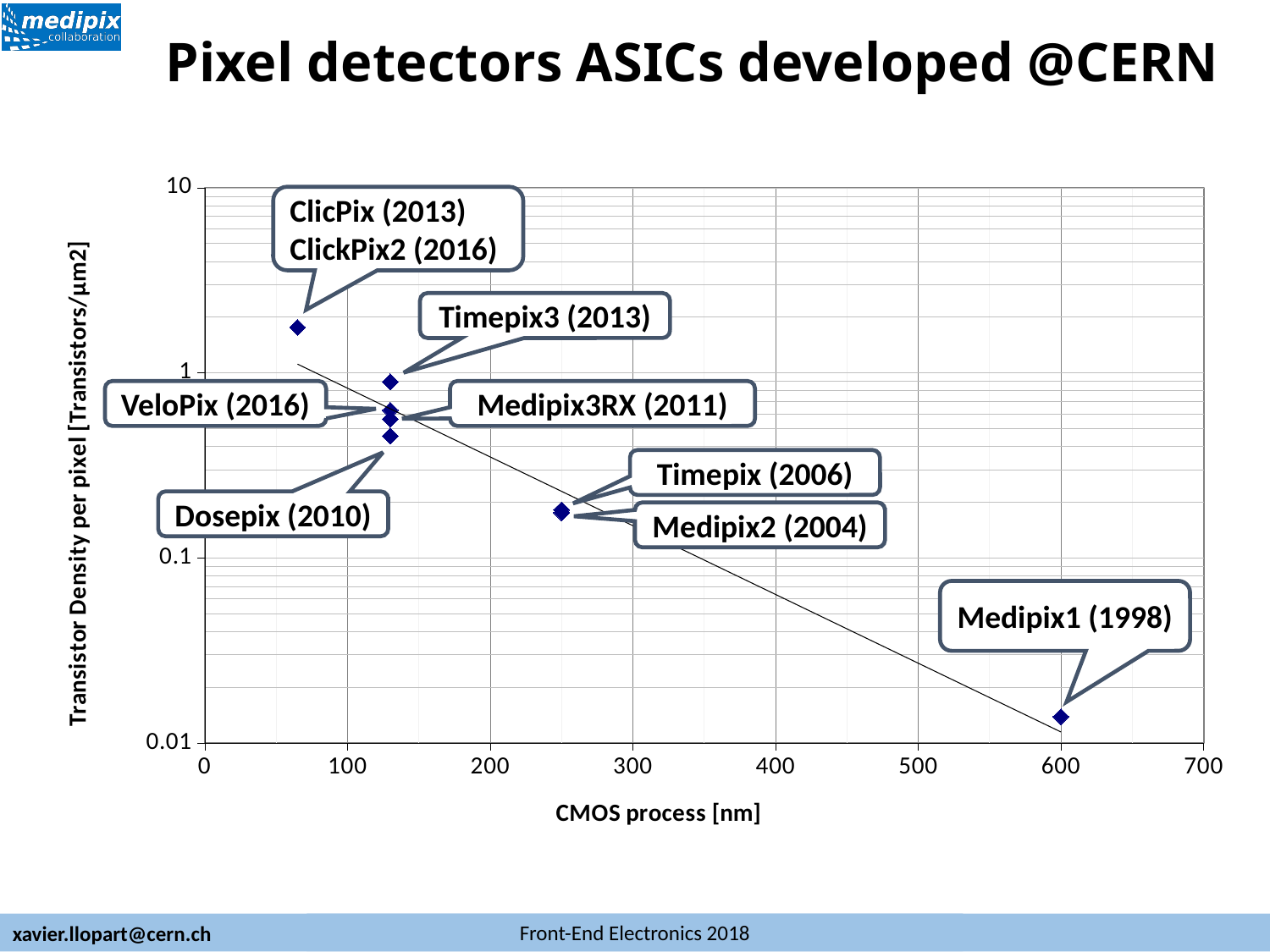
How does transistor density per pixel change as the CMOS process node increases? it falls What is the title of the chart? Pixel detectors ASICs developed @CERN Which chip has the highest transistor density per pixel? ClicPix (2013) / ClickPix2 (2016) Is the transistor density for Medipix1 (1998) greater or less than 0.1? less Which has a higher transistor density per pixel, Timepix3 (2013) or Medipix2 (2004)? Timepix3 (2013) What kind of chart is shown on the slide? scatter chart Is the transistor density for Timepix (2006) greater or less than 1? less Is the transistor density for ClicPix (2013) greater or less than 1? greater Which chip has the lowest transistor density per pixel? Medipix1 (1998) What CMOS process node is Medipix1 (1998) plotted at? 600 nm How many chip names are labelled on the chart? 9 What is the label of the x axis? CMOS process [nm]